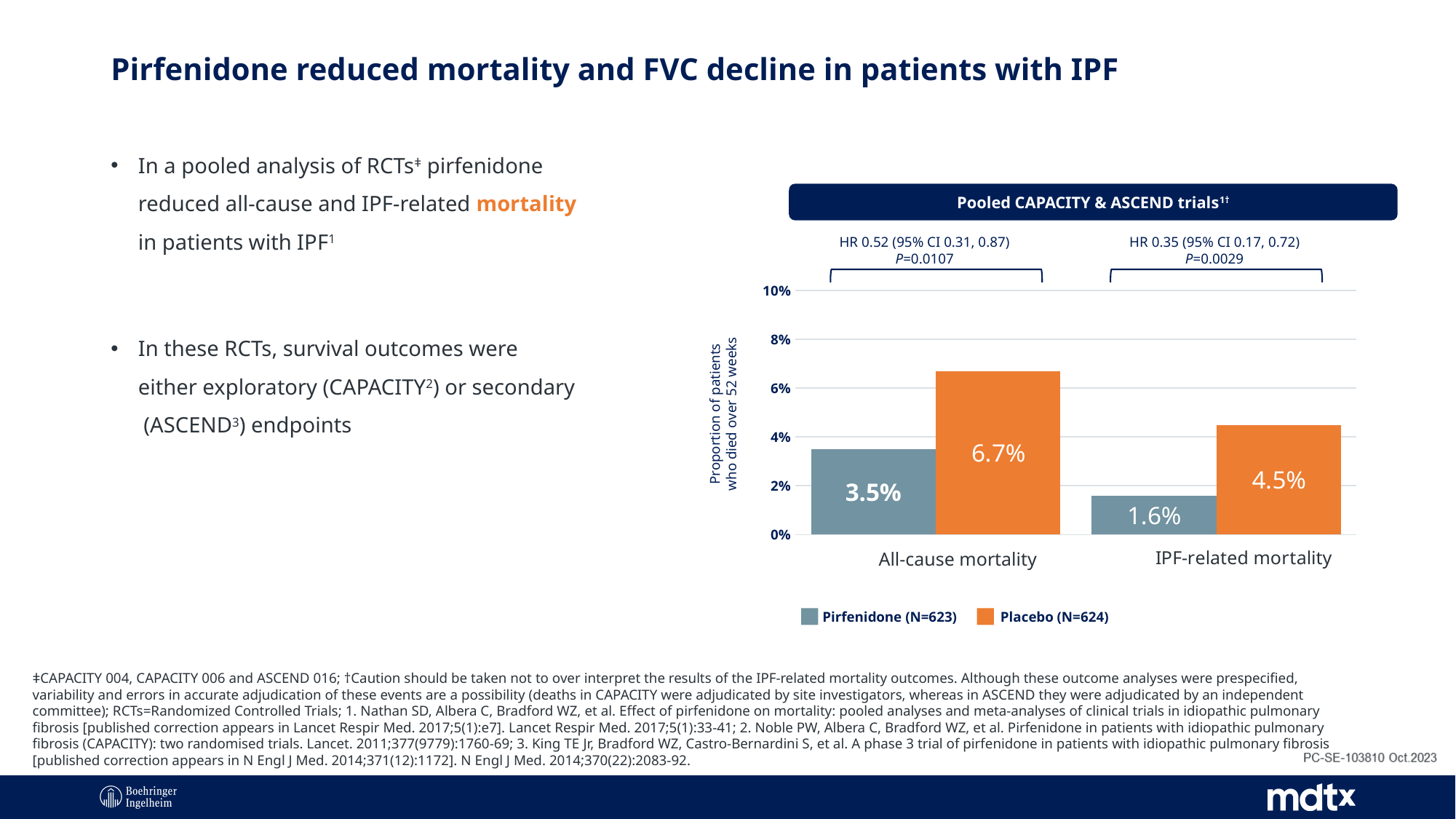
What is the all-cause mortality value for Placebo? 6.7% What is the difference between the Placebo and Pirfenidone values for IPF-related mortality? 2.9% For IPF-related mortality, which is larger: Pirfenidone or Placebo? Placebo Which bar in the chart has the highest value? Placebo, All-cause mortality What is the difference between the Placebo and Pirfenidone values for all-cause mortality? 3.2% What is the IPF-related mortality value for Pirfenidone? 1.6% How many series does the chart legend list? 2 How many categories are shown on the x axis of the chart? 2 Which bar in the chart has the lowest value? Pirfenidone, IPF-related mortality What kind of chart is shown on the slide? Bar chart What is the all-cause mortality value for Pirfenidone? 3.5% What is the IPF-related mortality value for Placebo? 4.5%